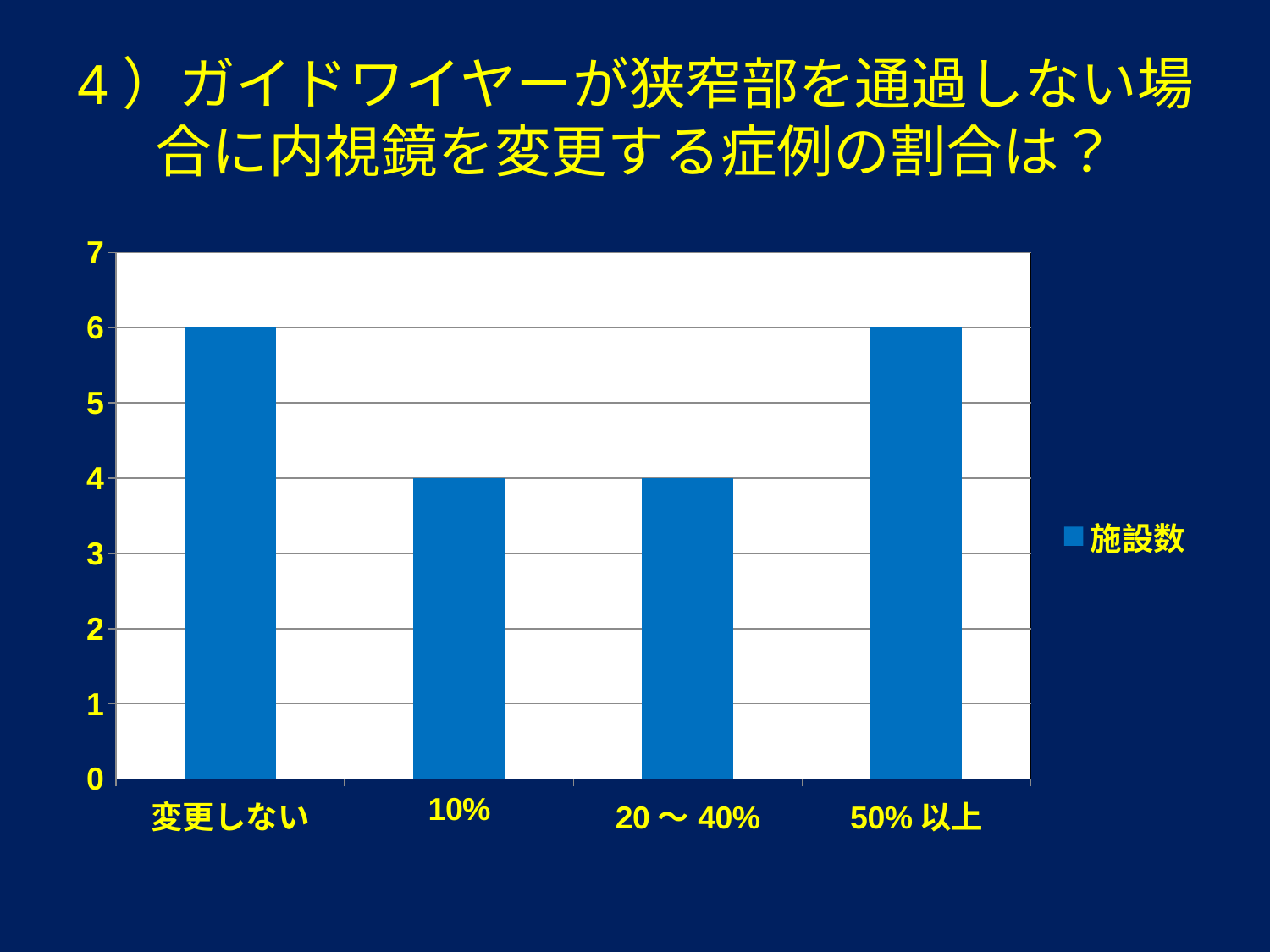
Is the value for 10% greater or less than 5? less How many categories are shown on the x axis of the chart? 4 What is the difference between the value for 変更しない and the value for 20～40%? 2 What is the value for 変更しない? 6 Which is larger, the value for 20～40% or the value for 50% 以上? 50% 以上 What is the name of the series shown in the legend? 施設数 Which is larger, the value for 変更しない or the value for 10%? 変更しない What type of chart is shown on the slide? bar chart What is the value for 20～40%? 4 What is the value for 10%? 4 How many series does the legend list? 1 What is the value for 50% 以上? 6